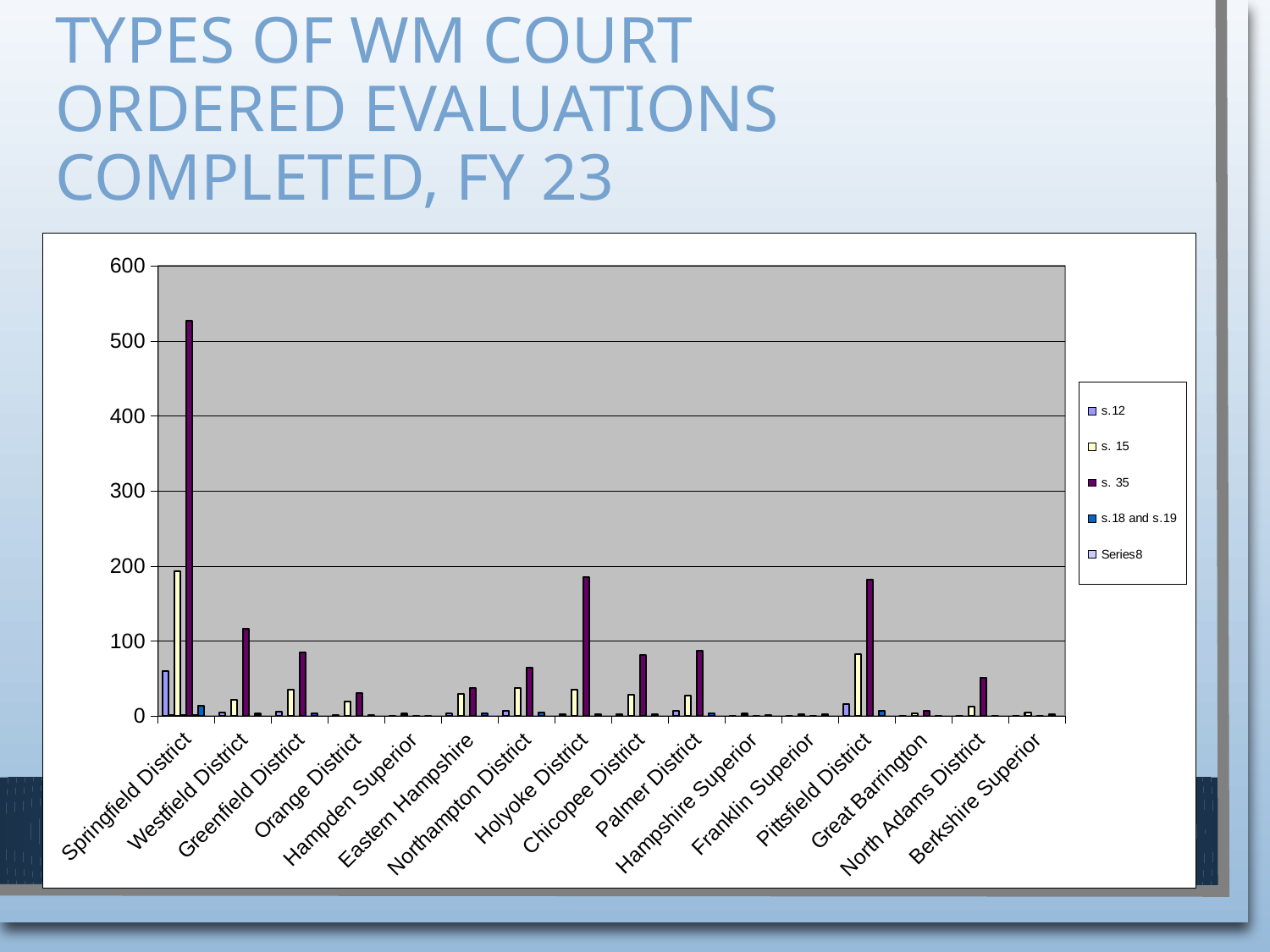
Is the s. 15 value for Springfield District greater or less than 100? greater What kind of chart is shown on the slide? bar chart How many series does the legend list? 5 How many court categories are shown along the x axis? 16 Which is larger, the s. 35 value for Holyoke District or the s. 35 value for Westfield District? Holyoke District Is the s. 35 value for Orange District greater or less than 100? less What is the title of the slide containing the chart? TYPES OF WM COURT ORDERED EVALUATIONS COMPLETED, FY 23 Is the s. 35 value for Springfield District greater or less than 500? greater What is the highest value shown on the y axis? 600 Which is larger, the s. 15 value for Springfield District or the s. 15 value for Pittsfield District? Springfield District Which court has the highest s. 35 value? Springfield District